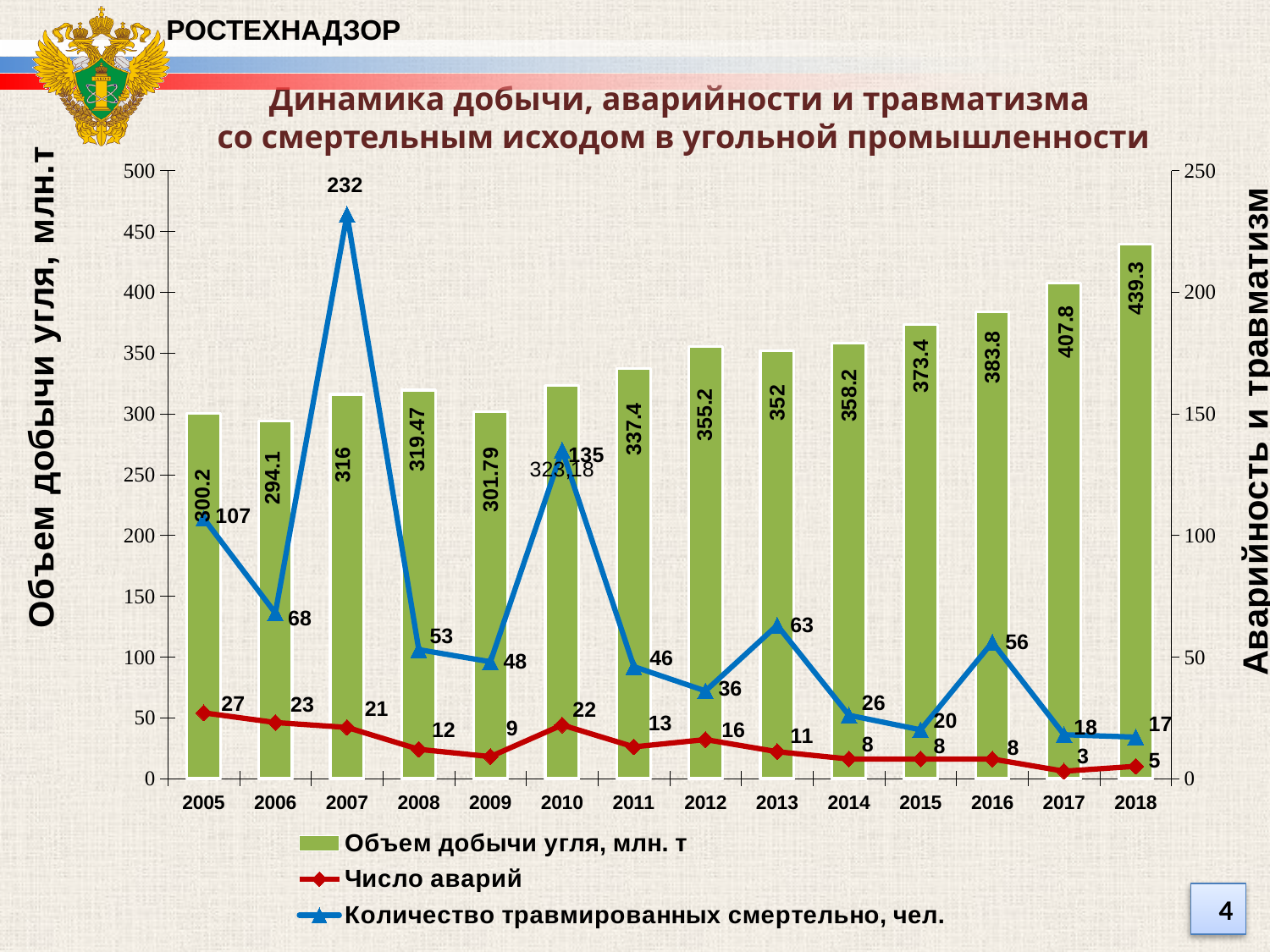
What was the coal production volume (Объем добычи угля, млн. т) in 2018? 439.3 Which year had more accidents, 2005 or 2012? 2005 In which year was the number of accidents the lowest? 2017 What is the difference between the number of fatally injured people in 2010 and in 2011? 89 How many fatally injured people (Количество травмированных смертельно) were recorded in 2007? 232 In which year was coal production the lowest? 2006 In which year was the number of fatally injured people the highest? 2007 What kind of chart is shown on the slide? Combined bar and line chart What is the difference in coal production between 2018 and 2017? 31.5 How many series does the legend list? 3 How many years are shown on the x axis? 14 What was the number of accidents (Число аварий) in 2010? 22